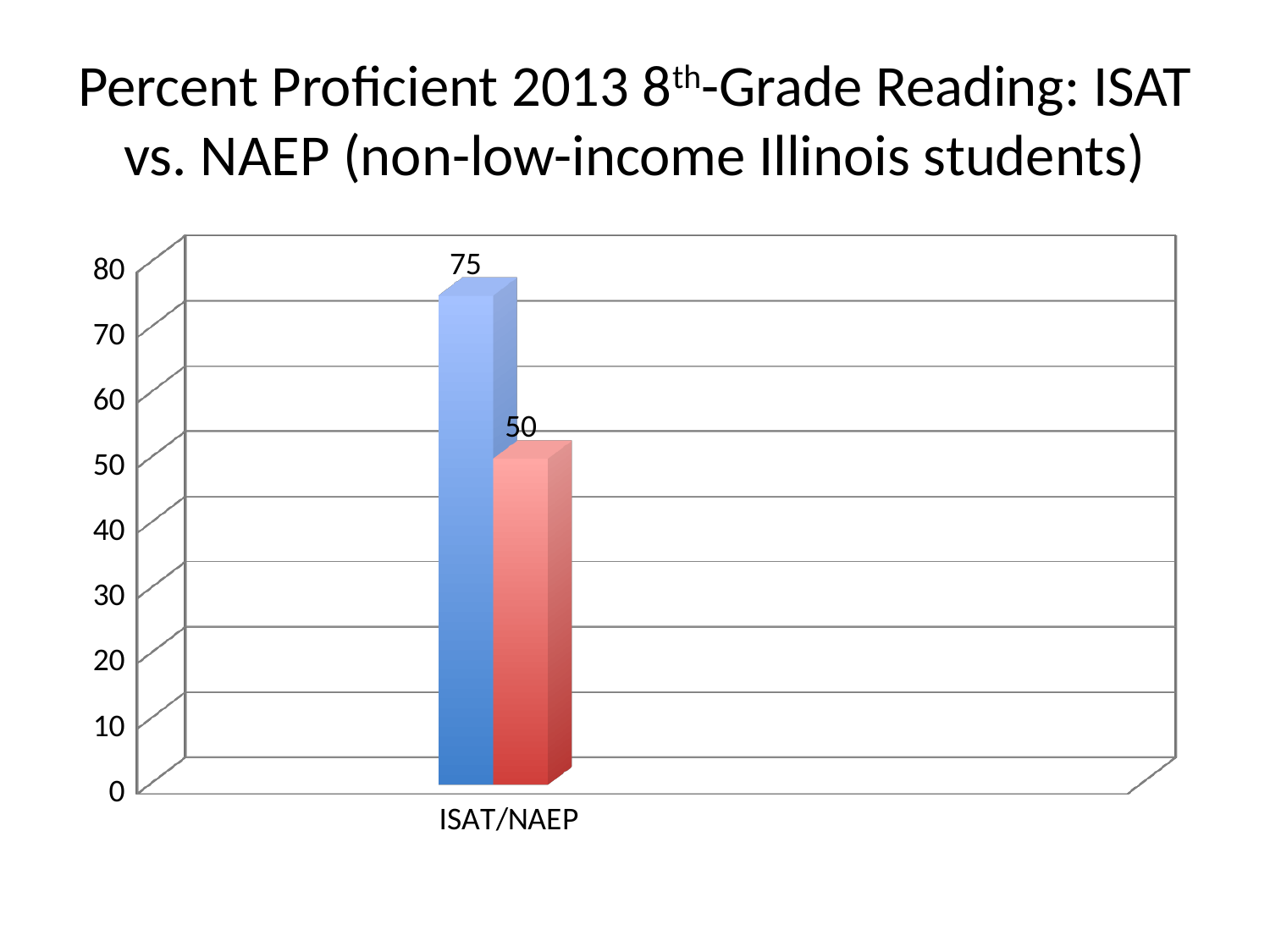
What value is shown on the blue bar in the chart? 75 What kind of chart is shown on the slide? bar chart What is the highest value shown on the vertical axis of the chart? 80 What is the highest value among the bars in the chart? 75 How many bars are plotted in the chart? 2 Which bar is taller, the blue bar or the red bar? the blue bar What is the difference between the blue bar's value and the red bar's value? 25 What is the lowest value among the bars in the chart? 50 Is the value of the blue bar greater or less than 70? greater What value is shown on the red bar in the chart? 50 What is the category label shown on the x axis of the chart? ISAT/NAEP Is the value of the red bar greater or less than 60? less